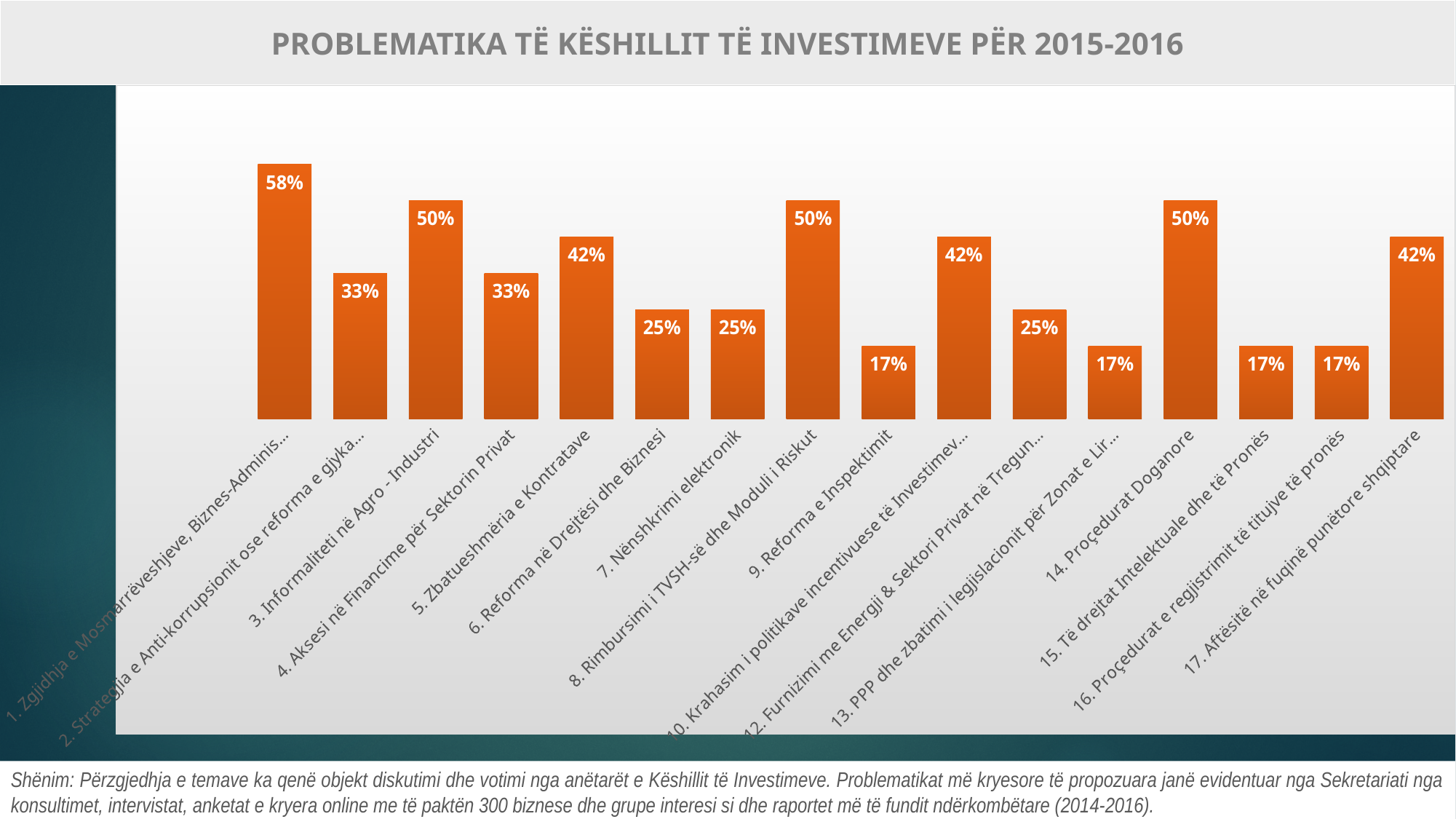
What is the value for "14. Proçedurat Doganore"? 50% What type of chart is shown on the slide? Bar chart What is the value for "5. Zbatueshmëria e Kontratave"? 42% What is the title of the chart? PROBLEMATIKA TË KËSHILLIT TË INVESTIMEVE PËR 2015-2016 What is the lowest value shown in the chart? 17% What is the highest value shown in the chart? 58% What is the difference between the values for "8. Rimbursimi i TVSH-së dhe Moduli i Riskut" and "7. Nënshkrimi elektronik"? 25% What is the value for "17. Aftësitë në fuqinë punëtore shqiptare"? 42% What is the value for "3. Informaliteti në Agro - Industri"? 50% What is the value for "9. Reforma e Inspektimit"? 17% Which has a larger value: "4. Aksesi në Financime për Sektorin Privat" or "6. Reforma në Drejtësi dhe Biznesi"? 4. Aksesi në Financime për Sektorin Privat How many bars are plotted in the chart? 16